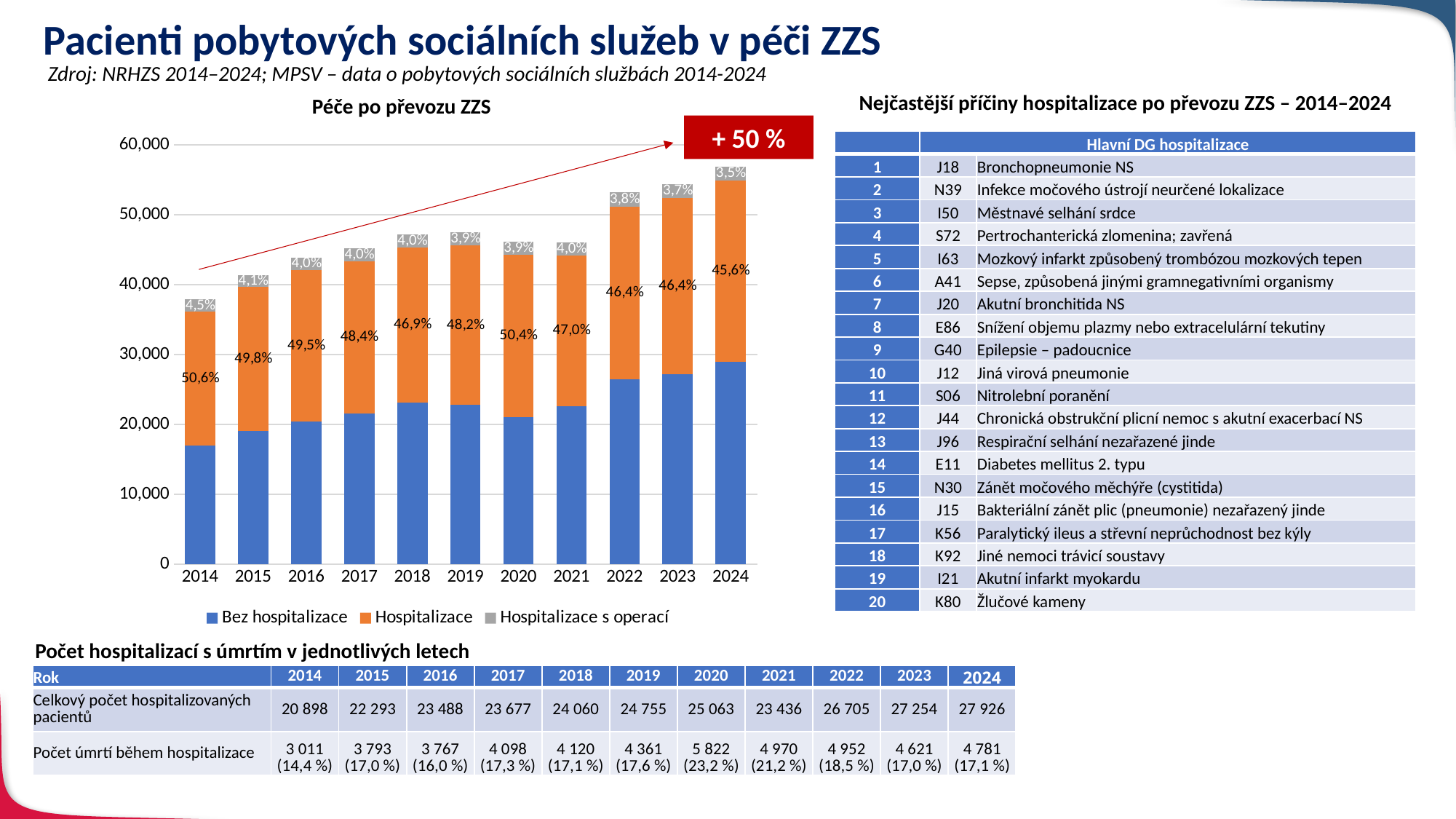
How many years are shown on the x axis of the "Péče po převozu ZZS" chart? 11 In the "Péče po převozu ZZS" chart, is the total height of the 2014 bar greater or less than 40,000? less In the "Péče po převozu ZZS" chart, which year has the shortest total bar? 2014 How many series does the legend of the "Péče po převozu ZZS" chart list? 3 In the "Péče po převozu ZZS" chart, which total bar is taller, 2014 or 2024? 2024 In the "Péče po převozu ZZS" chart, what percentage label is printed at the top of the 2014 bar? 4,5% What percentage increase is shown in the red annotation box on the "Péče po převozu ZZS" chart? + 50 % What kind of chart is "Péče po převozu ZZS"? Stacked bar chart In the "Péče po převozu ZZS" chart, which year has the tallest total bar? 2024 In the "Péče po převozu ZZS" chart, do the total bar heights generally rise or fall from 2014 to 2024? Rise In the "Péče po převozu ZZS" chart, what percentage label is printed in the orange (Hospitalizace) segment of the 2024 bar? 45,6% In the "Péče po převozu ZZS" chart, is the total height of the 2024 bar greater or less than 50,000? greater